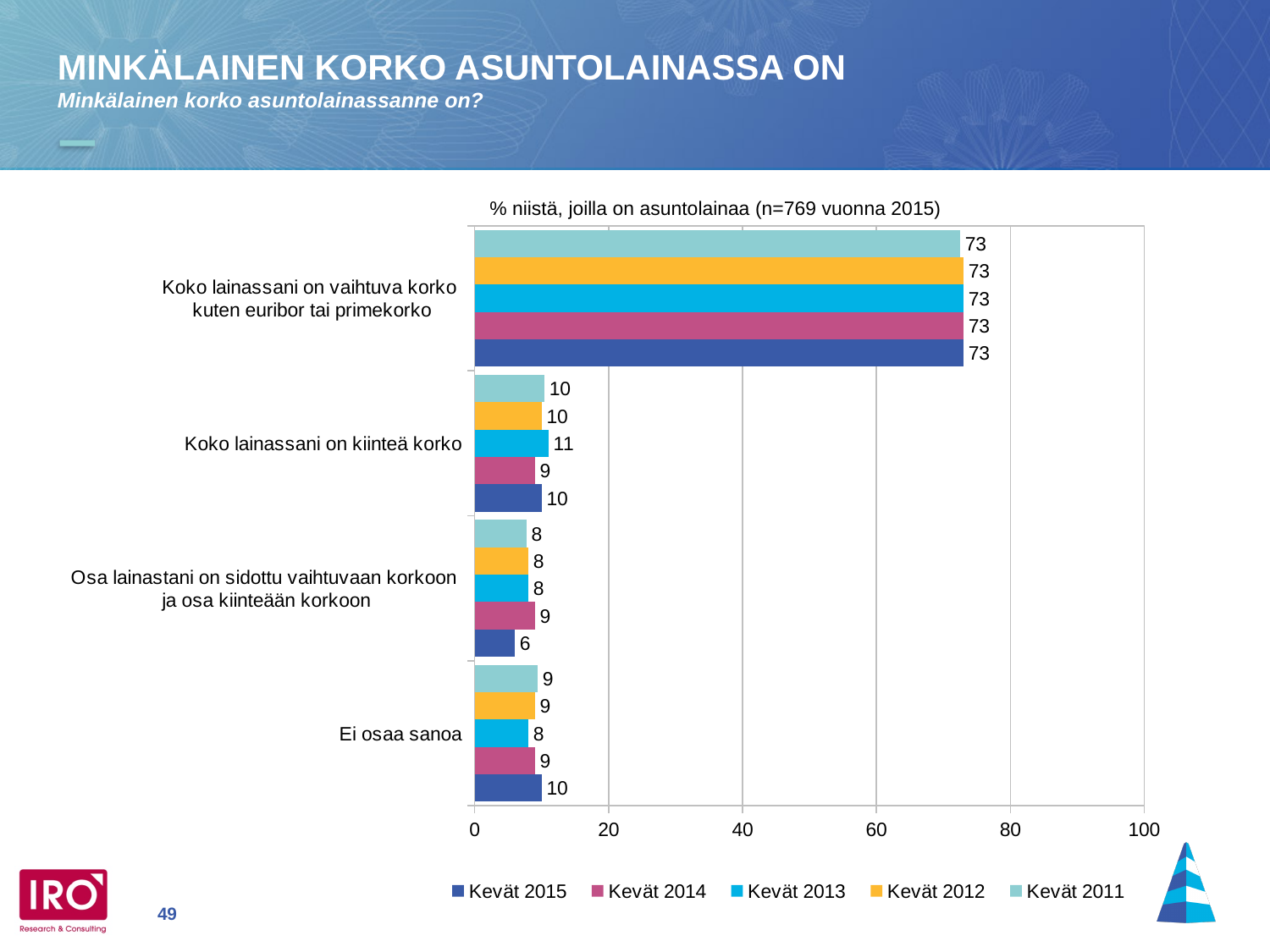
What is the value for 'Ei osaa sanoa' in Kevät 2014? 9 What is the value for 'Osa lainastani on sidottu vaihtuvaan korkoon ja osa kiinteään korkoon' in Kevät 2015? 6 What is the value for 'Koko lainassani on vaihtuva korko kuten euribor tai primekorko' in Kevät 2015? 73 What is the difference between the Kevät 2015 values for 'Koko lainassani on vaihtuva korko kuten euribor tai primekorko' and 'Koko lainassani on kiinteä korko'? 63 What kind of chart is shown on the slide? Bar chart What is the subtitle text shown above the chart? % niistä, joilla on asuntolainaa (n=769 vuonna 2015) How many series does the legend list? 5 Which category has the highest value in Kevät 2015? Koko lainassani on vaihtuva korko kuten euribor tai primekorko How many categories are shown on the chart? 4 For 'Osa lainastani on sidottu vaihtuvaan korkoon ja osa kiinteään korkoon', which is larger: the Kevät 2014 value or the Kevät 2015 value? Kevät 2014 Which category has the lowest value in Kevät 2015? Osa lainastani on sidottu vaihtuvaan korkoon ja osa kiinteään korkoon What is the value for 'Koko lainassani on kiinteä korko' in Kevät 2013? 11